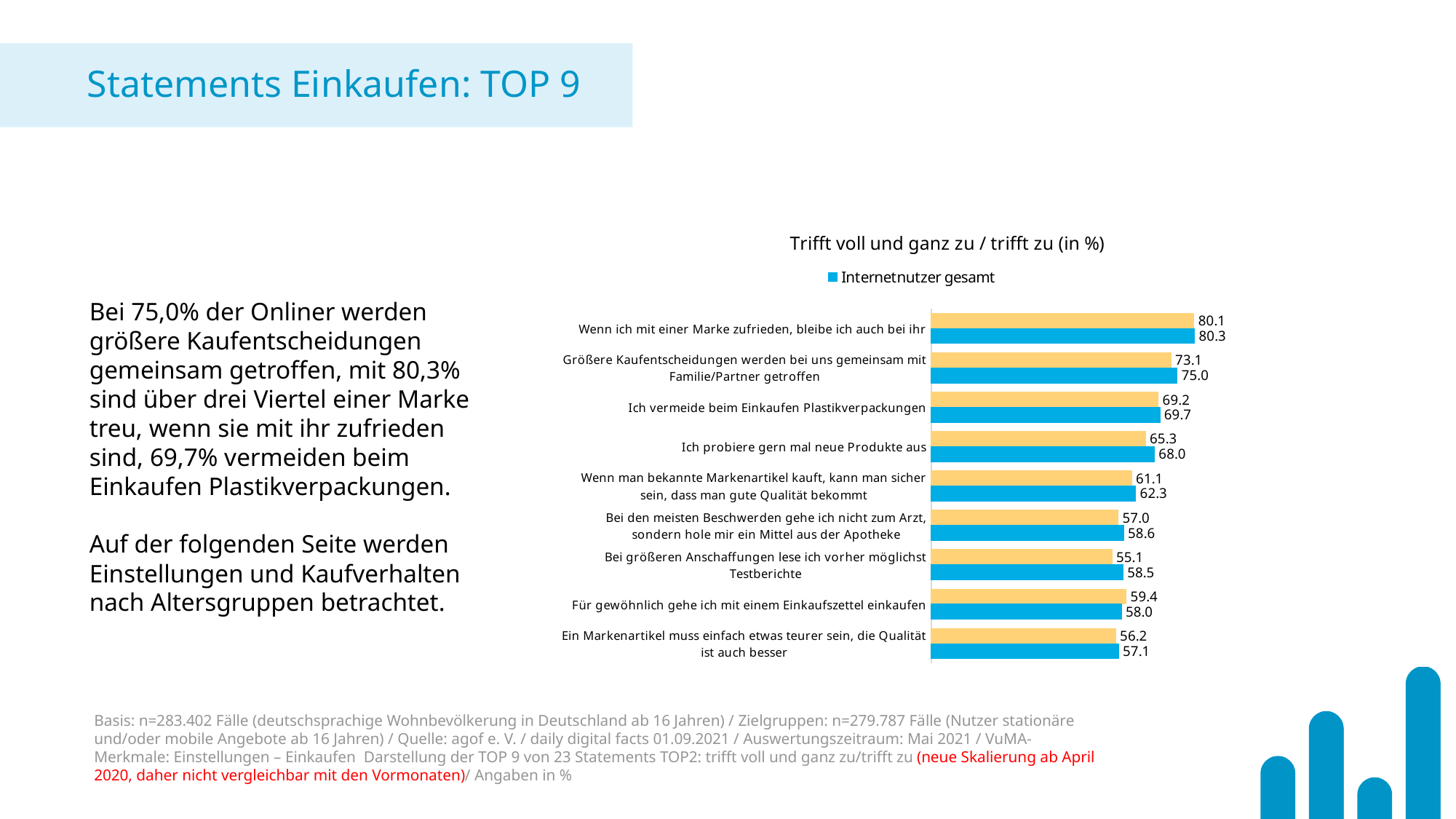
How many series does the legend list? 1 How many statements are shown in the chart? 9 Which statement has the highest "Internetnutzer gesamt" value? Wenn ich mit einer Marke zufrieden, bleibe ich auch bei ihr Which statement has the lowest "Internetnutzer gesamt" value? Ein Markenartikel muss einfach etwas teurer sein, die Qualität ist auch besser For "Für gewöhnlich gehe ich mit einem Einkaufszettel einkaufen", which is larger: the yellow bar or the "Internetnutzer gesamt" bar? The yellow bar What kind of chart is shown on the slide? Bar chart What is the difference between the yellow bar and the "Internetnutzer gesamt" bar for "Bei größeren Anschaffungen lese ich vorher möglichst Testberichte"? 3.4 What is the value for "Internetnutzer gesamt" for the statement "Wenn ich mit einer Marke zufrieden, bleibe ich auch bei ihr"? 80.3 What is the difference between the "Internetnutzer gesamt" values for "Größere Kaufentscheidungen werden bei uns gemeinsam mit Familie/Partner getroffen" and "Ich probiere gern mal neue Produkte aus"? 7.0 What is the title of the chart? Trifft voll und ganz zu / trifft zu (in %) What value does the yellow bar show for "Ich probiere gern mal neue Produkte aus"? 65.3 What is the value for "Internetnutzer gesamt" for "Ich vermeide beim Einkaufen Plastikverpackungen"? 69.7